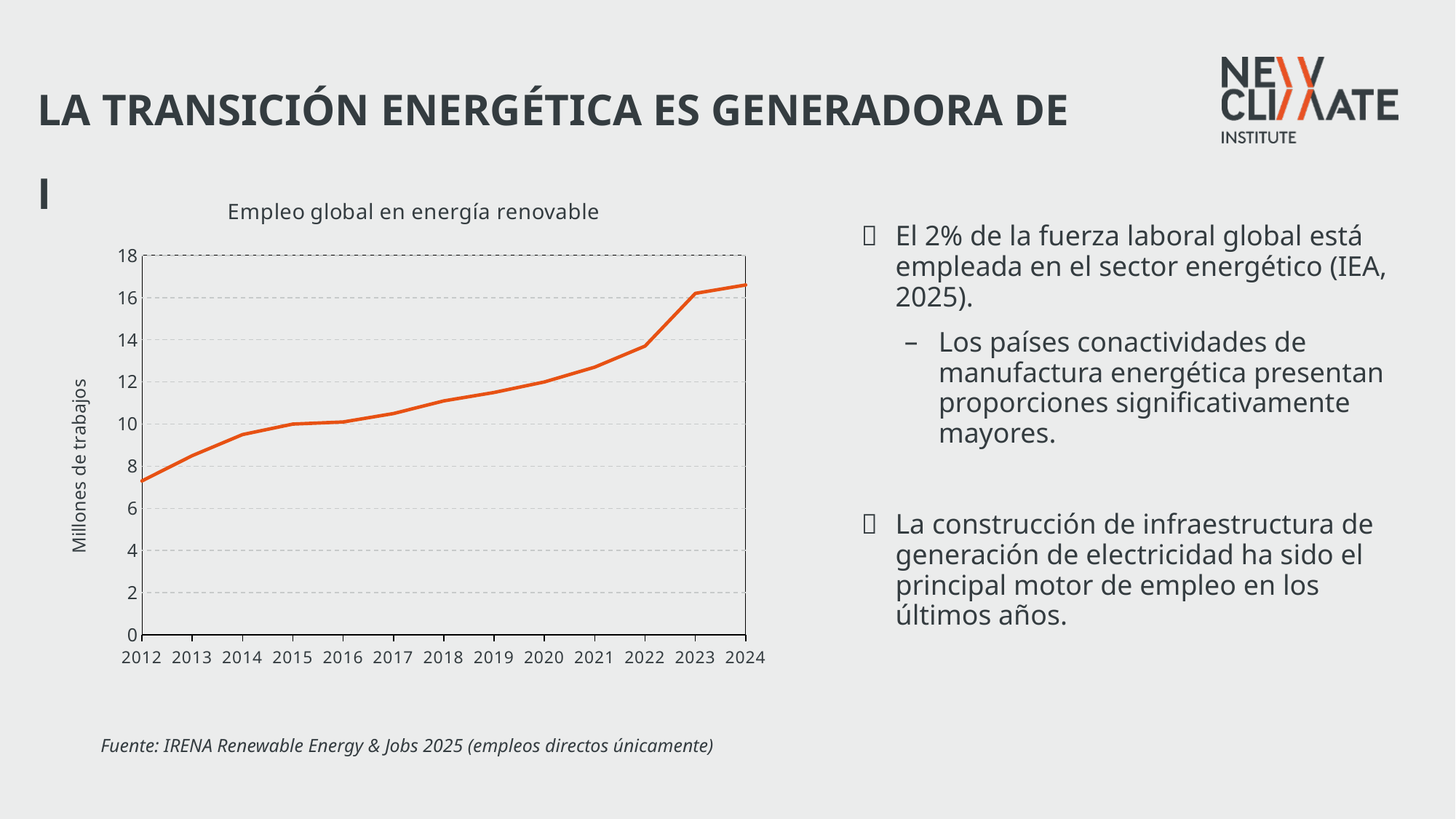
Which year has the lowest value in the chart? 2012 What is the title of the chart? Empleo global en energía renovable Is the value for 2022 greater or less than 14? less Is the value for 2018 greater or less than 10? greater Which year has the larger value, 2022 or 2023? 2023 What kind of chart is shown on the slide? line chart Do the values in the chart rise or fall from 2012 to 2024? rise What is the label of the vertical axis of the chart? Millones de trabajos How many years are plotted along the x axis of the chart? 13 Is the value for 2024 greater or less than 16? greater Which year has the highest value in the chart? 2024